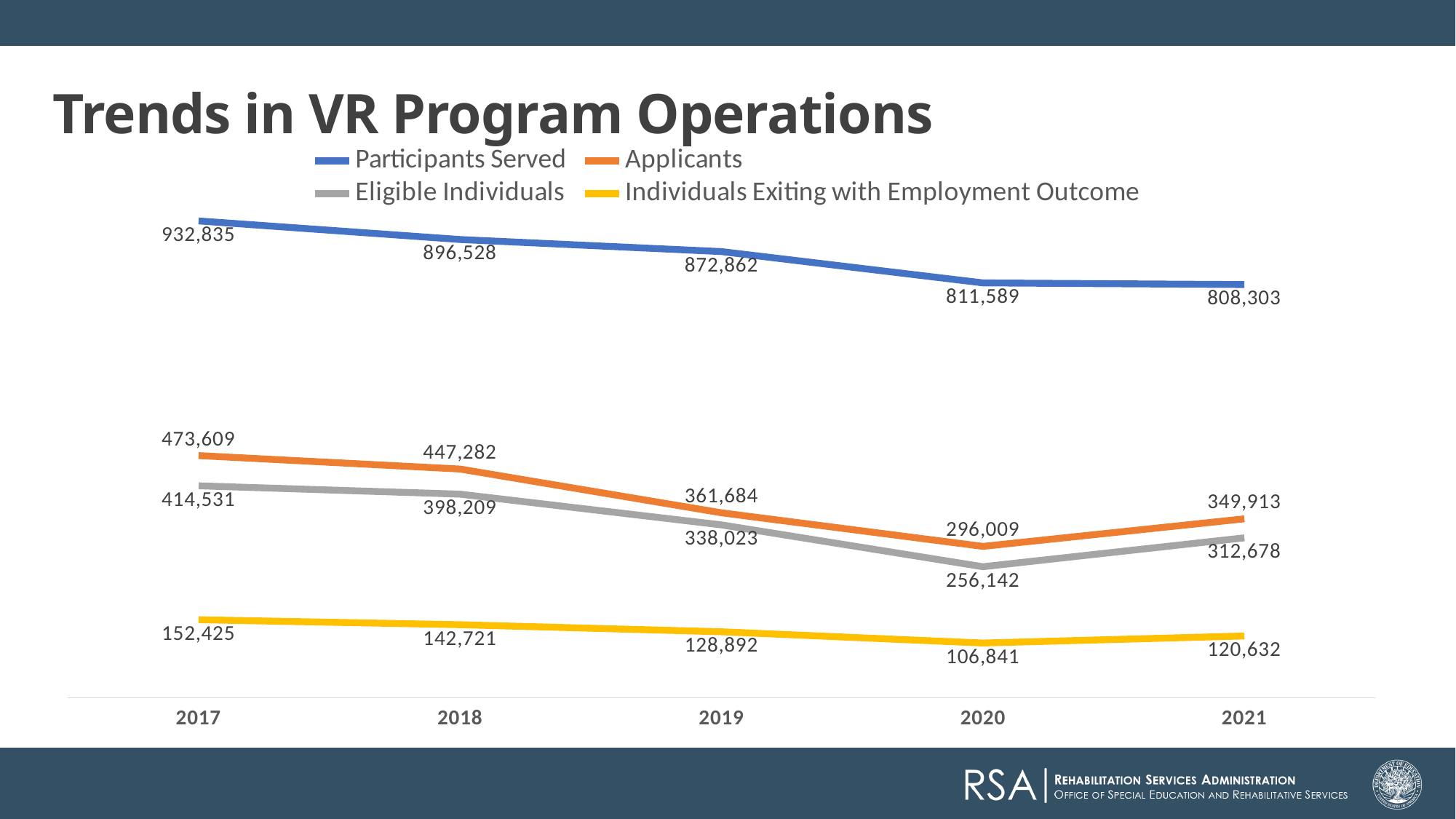
What is the value for Participants Served in 2019? 872,862 What is the value for Individuals Exiting with Employment Outcome in 2018? 142,721 What is the value for Applicants in 2021? 349,913 Does the Participants Served line rise or fall from 2017 to 2021? Fall What is the difference between Participants Served in 2017 and in 2021? 124,532 What type of chart is shown on the slide? Line chart What is the value for Eligible Individuals in 2020? 256,142 How many series does the legend list? 4 In which year was the number of Applicants lowest? 2020 Which is larger in 2019: Applicants or Eligible Individuals? Applicants In which year was the number of Participants Served highest? 2017 How many years are shown on the x axis? 5